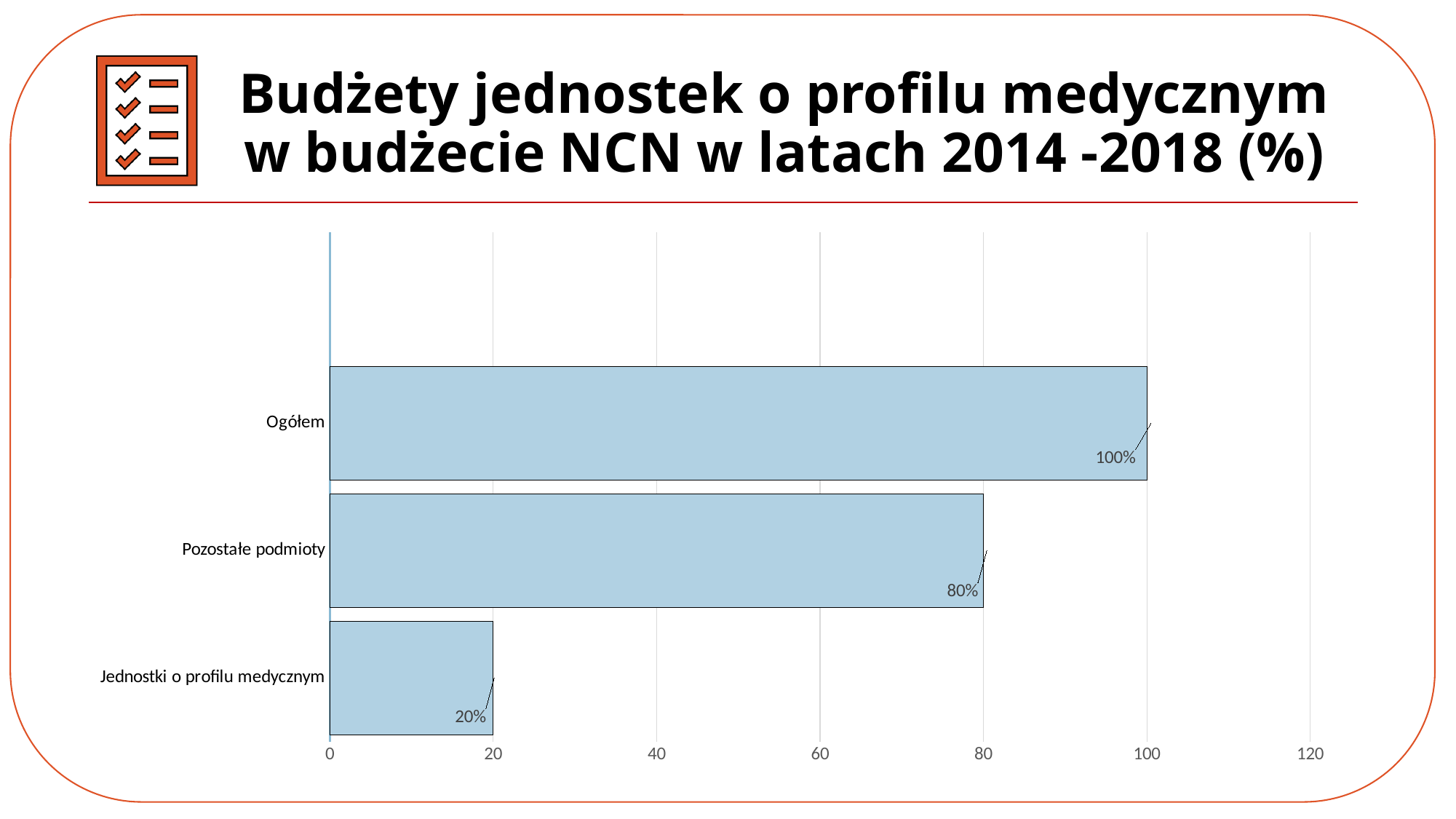
Which category has the highest value? Ogółem What is the value for Pozostałe podmioty? 80% How many categories are shown in the chart? 3 Which category has the lowest value? Jednostki o profilu medycznym What is the value for Jednostki o profilu medycznym? 20% Which is larger, the value for Pozostałe podmioty or the value for Jednostki o profilu medycznym? Pozostałe podmioty What kind of chart is shown on the slide? bar chart What is the difference between the values for Ogółem and Pozostałe podmioty? 20% What is the title of the slide? Budżety jednostek o profilu medycznym w budżecie NCN w latach 2014 -2018 (%) Is the value for Pozostałe podmioty greater or less than 60? greater What is the difference between the values for Pozostałe podmioty and Jednostki o profilu medycznym? 60% What is the value for Ogółem? 100%